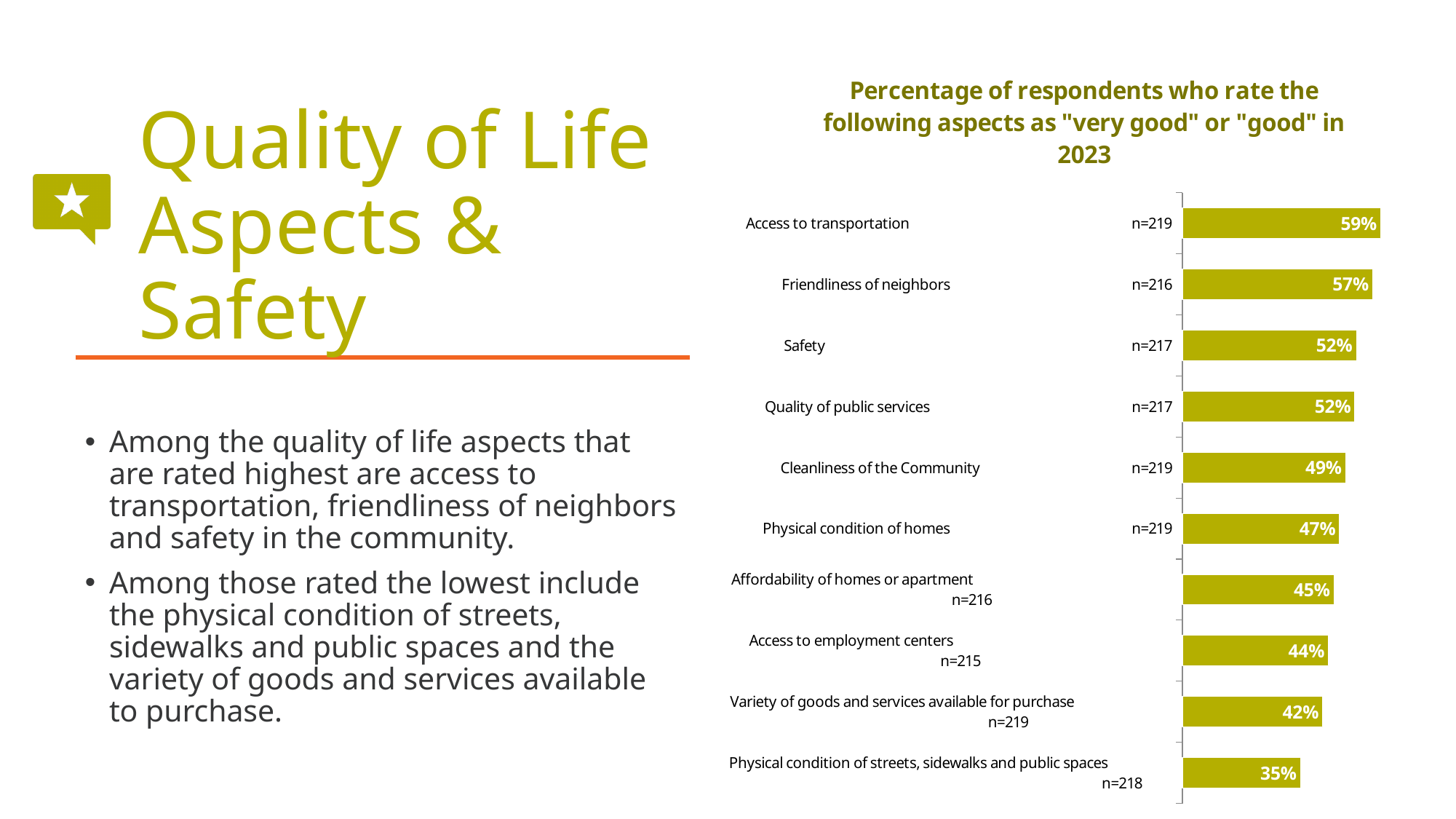
What is the value shown for Cleanliness of the Community? 49% What is the title of the chart? Percentage of respondents who rate the following aspects as "very good" or "good" in 2023 Which has a higher percentage: Affordability of homes or apartment or Access to employment centers? Affordability of homes or apartment What is the sample size (n) shown for Access to employment centers? n=215 What percentage of respondents rated Access to transportation as "very good" or "good" in 2023? 59% What kind of chart is shown on the slide? Bar chart What is the difference in percentage points between Friendliness of neighbors and Safety? 5 Which aspect has the highest percentage of "very good" or "good" ratings? Access to transportation Which aspect has the lowest percentage of "very good" or "good" ratings? Physical condition of streets, sidewalks and public spaces What percentage is shown for Physical condition of streets, sidewalks and public spaces? 35% What is the difference in percentage points between Access to transportation and Physical condition of streets, sidewalks and public spaces? 24 How many aspects are shown in the chart? 10